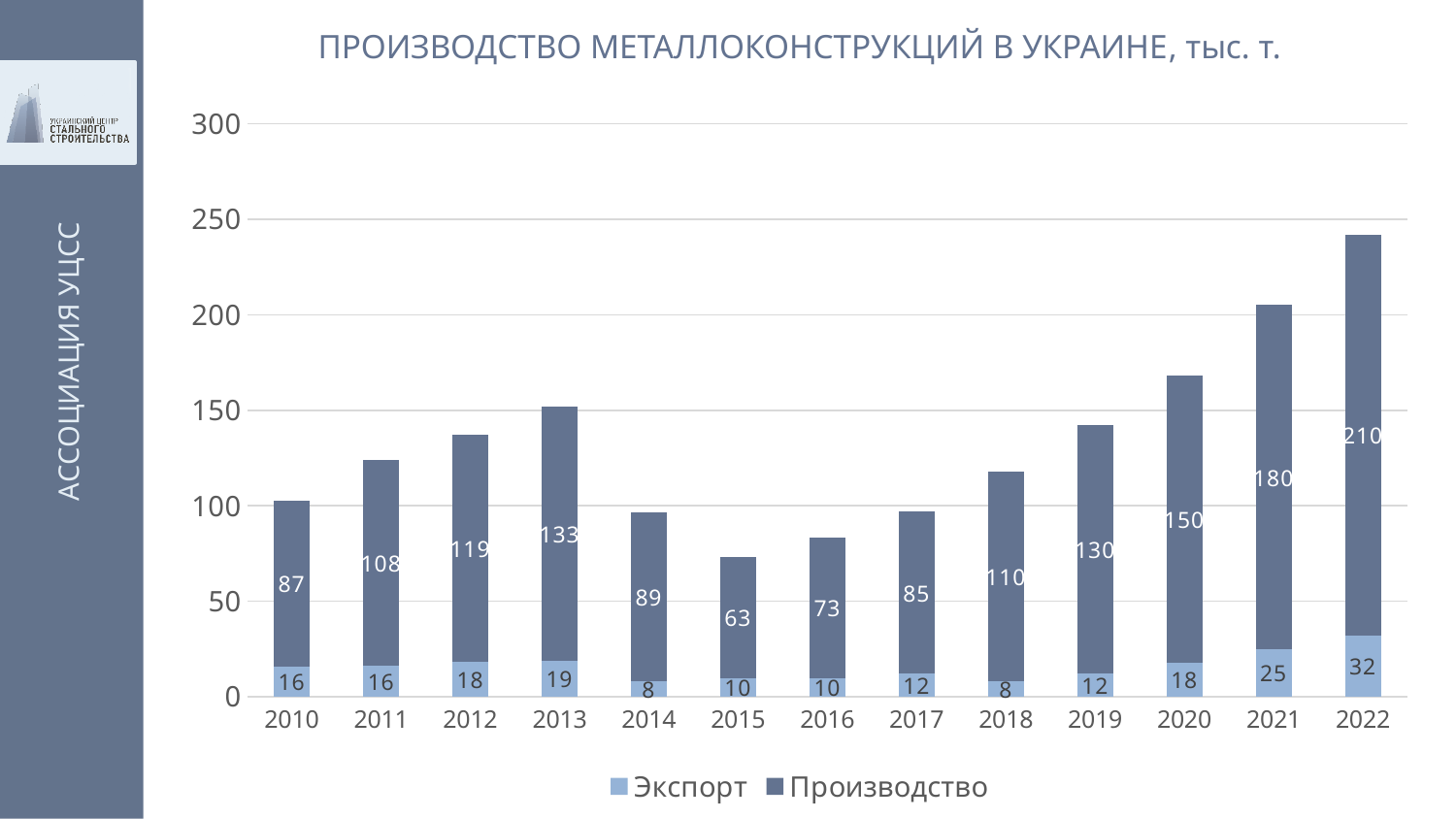
In which year is the Производство value the lowest? 2015 What type of chart is shown on the slide? Stacked bar chart Which is larger, the Производство value for 2012 or for 2018? 2012 What is the value of Экспорт for 2021? 25 Does the Производство value rise or fall from 2018 to 2022? Rise What is the total of the stacked bar for 2022? 242 How many years are shown on the x axis? 13 What is the value of Производство for 2013? 133 What is the title of the chart? ПРОИЗВОДСТВО МЕТАЛЛОКОНСТРУКЦИЙ В УКРАИНЕ, тыс. т. What is the difference between the Производство values for 2022 and 2021? 30 How many series does the legend list? 2 In which year is the Экспорт value the highest? 2022